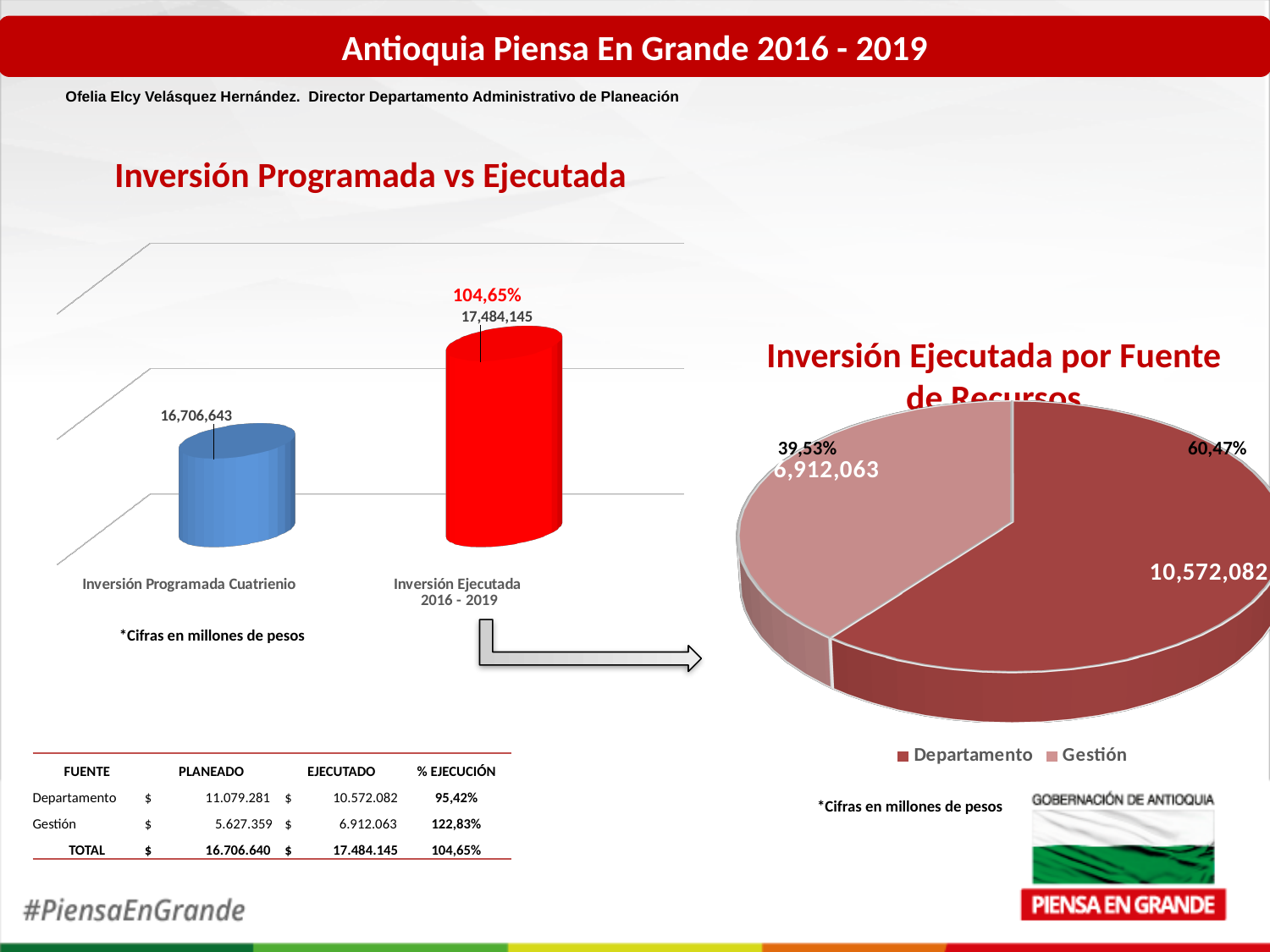
How many entries does the legend of the 'Inversión Ejecutada por Fuente de Recursos' chart list? 2 In the 'Inversión Programada vs Ejecutada' chart, what is the value for Inversión Ejecutada 2016 - 2019? 17,484,145 In the 'Inversión Ejecutada por Fuente de Recursos' chart, what share of the pie does Gestión represent? 39,53% In the 'Inversión Programada vs Ejecutada' chart, what is the value for Inversión Programada Cuatrienio? 16,706,643 In the 'Inversión Programada vs Ejecutada' chart, which category has the higher value? Inversión Ejecutada 2016 - 2019 In the 'Inversión Programada vs Ejecutada' chart, what percentage is shown above the Inversión Ejecutada 2016 - 2019 bar? 104,65% In the 'Inversión Ejecutada por Fuente de Recursos' chart, which slice is the largest? Departamento In the 'Inversión Ejecutada por Fuente de Recursos' chart, what is the value for Departamento? 10,572,082 In the 'Inversión Programada vs Ejecutada' chart, what is the difference between Inversión Ejecutada 2016 - 2019 and Inversión Programada Cuatrienio? 777,502 What kind of chart is 'Inversión Ejecutada por Fuente de Recursos'? pie chart How many bars are in the 'Inversión Programada vs Ejecutada' chart? 2 What kind of chart is 'Inversión Programada vs Ejecutada'? bar chart